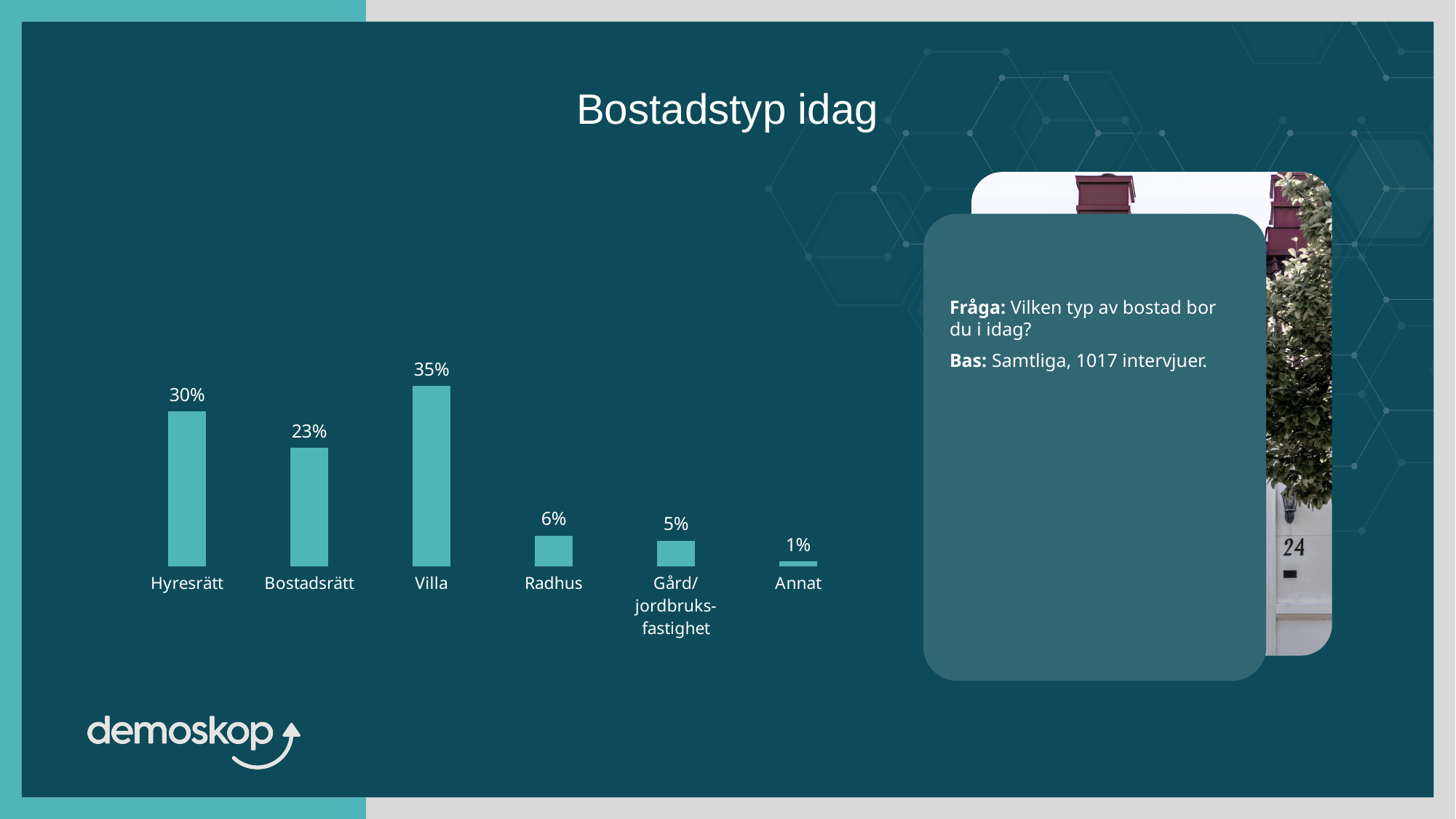
Which category has the lowest value? Annat What is the value for Gård/jordbruksfastighet? 5% Which category has the highest value? Villa What is the value for Hyresrätt? 30% What is the title of the slide? Bostadstyp idag Which is larger, the value for Hyresrätt or the value for Bostadsrätt? Hyresrätt How many categories are shown in the chart? 6 What kind of chart is shown on the slide? Bar chart What is the value for Bostadsrätt? 23% What is the difference between the values for Villa and Hyresrätt? 5% What is the value for Radhus? 6% What is the value for Villa? 35%